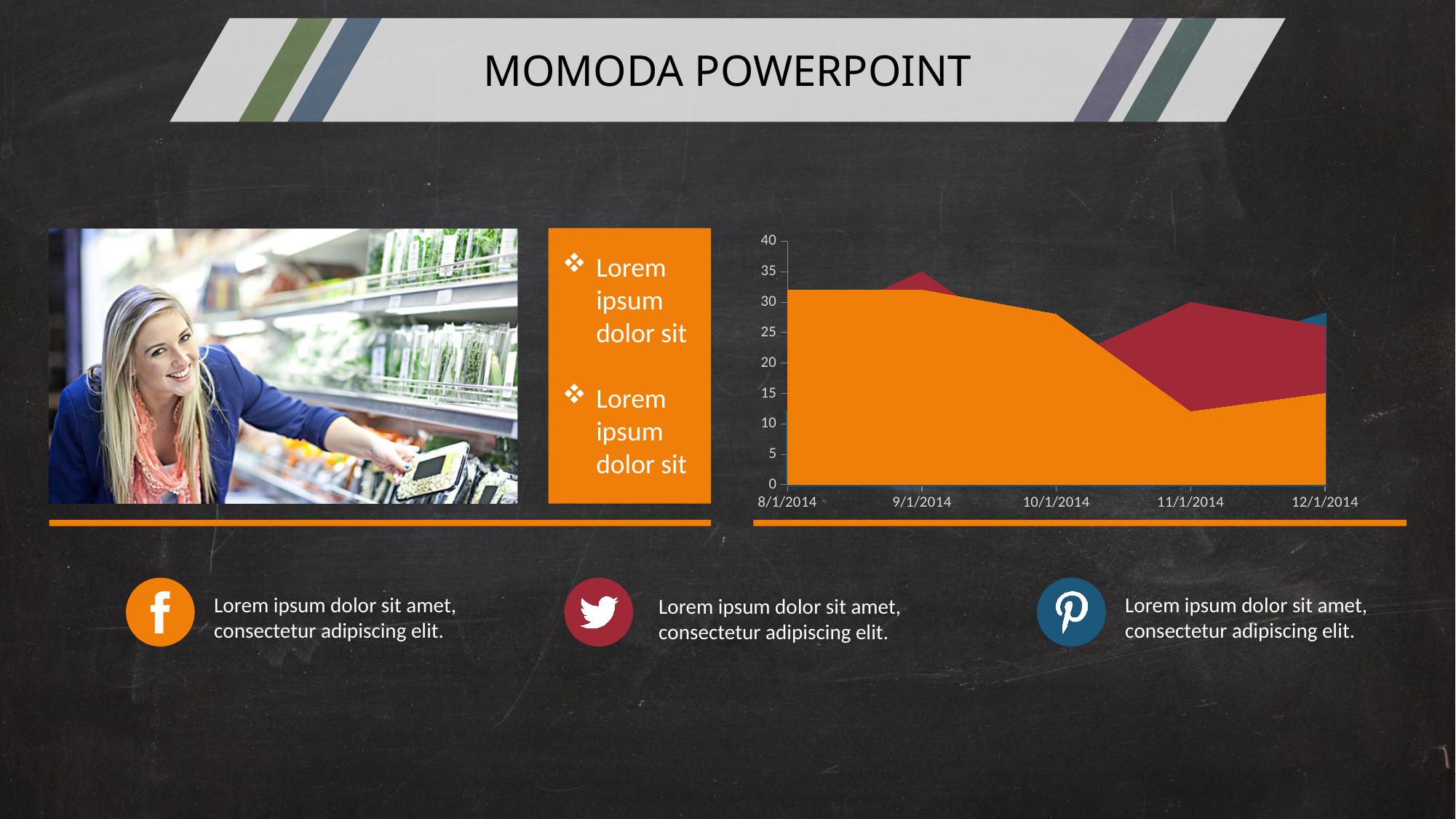
Is the value of the orange series at 12/1/2014 greater or less than 20? less Is the value of the red series at 11/1/2014 greater or less than 25? greater How many dates are labelled on the x axis of the area chart? 5 Is the value of the orange series at 8/1/2014 greater or less than 30? greater What is the highest value shown on the y axis of the area chart? 40 Is the orange series higher at 10/1/2014 or at 11/1/2014? 10/1/2014 What kind of chart is shown on the right of the slide? area chart At which date does the orange series reach its lowest value? 11/1/2014 Does the orange series generally rise or fall from 8/1/2014 to 11/1/2014? fall What is the first date shown on the x axis of the area chart? 8/1/2014